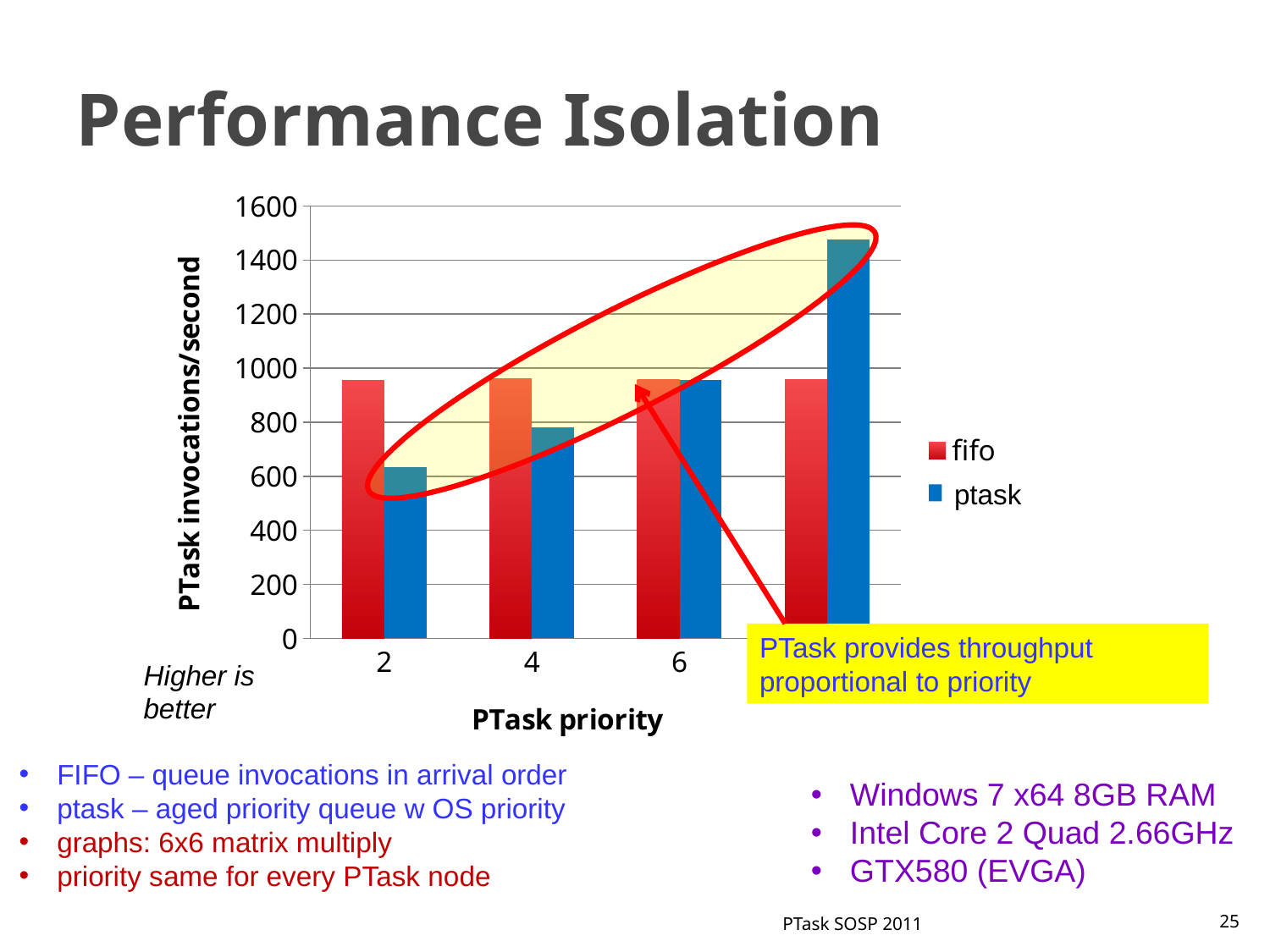
Do the ptask values rise or fall as PTask priority increases along the x axis? rise What is the title of the y axis? PTask invocations/second Which series reaches the highest value anywhere on the chart? ptask What kind of chart is shown on the slide? bar chart Is the ptask value at PTask priority 4 greater or less than 1000? less Is the fifo value at PTask priority 2 greater or less than 800? greater Is the ptask value at PTask priority 2 greater or less than 800? less At PTask priority 2, which series has the larger value, fifo or ptask? fifo How many groups of bars are plotted along the x axis? 4 How many series does the legend list? 2 Which series are listed in the legend? fifo and ptask At PTask priority 4, which series has the larger value, fifo or ptask? fifo